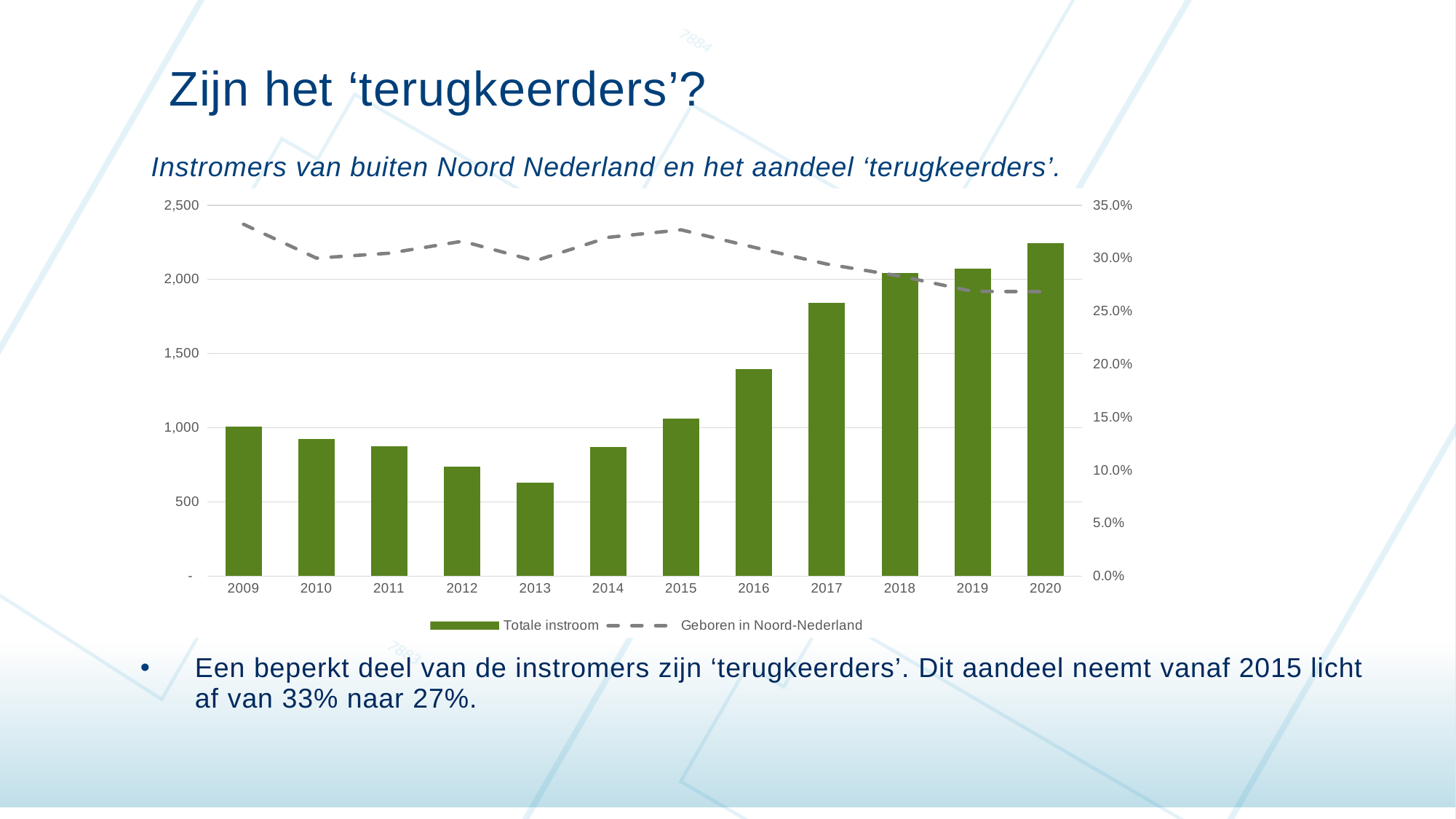
Is the Geboren in Noord-Nederland share for 2020 greater or less than 30.0%? less Which year has the lowest bar for Totale instroom? 2013 Is the Totale instroom value for 2013 greater or less than 1,000? less What kind of chart is shown on the slide? A bar chart combined with a dashed line How many series does the chart legend list? 2 Does the Geboren in Noord-Nederland dashed line rise or fall from 2015 to 2020? fall Is the Totale instroom value for 2020 greater or less than 2,000? greater How many years are shown along the x axis of the chart? 12 Which year has a larger Totale instroom, 2015 or 2017? 2017 What are the two series named in the chart legend? Totale instroom and Geboren in Noord-Nederland Which year has the highest bar for Totale instroom? 2020